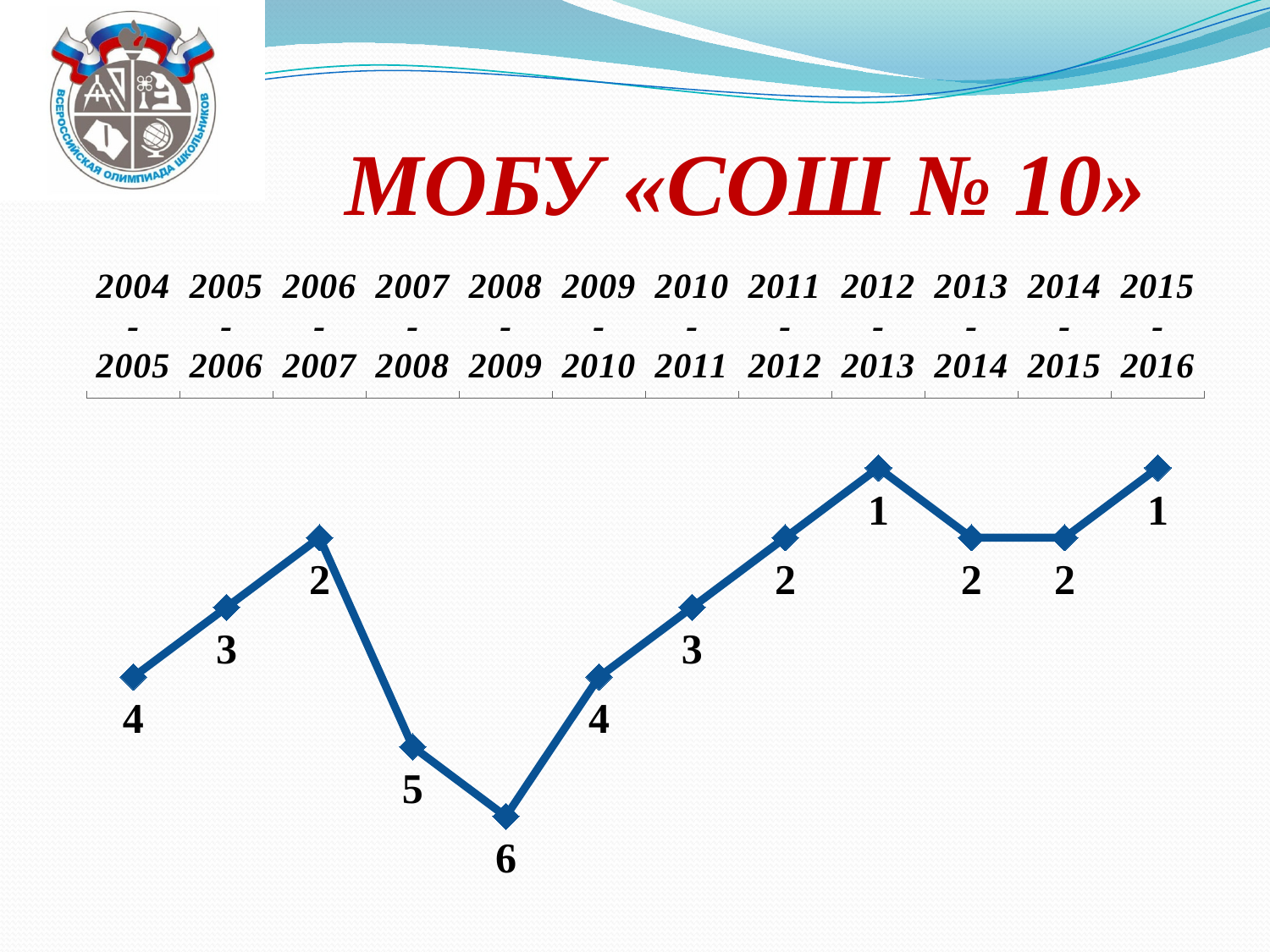
What is the difference between the values for 2008-2009 and 2004-2005? 2 What is the value for 2014-2015? 2 How many periods are plotted on the chart? 12 Which period has the largest numeric value? 2008-2009 What kind of chart is shown on the slide? line chart What is the value for 2004-2005? 4 Which is numerically larger, the value for 2007-2008 or the value for 2010-2011? 2007-2008 What is the value for 2010-2011? 3 What is the smallest numeric value plotted on the chart? 1 What is the value for 2012-2013? 1 What is the value for 2008-2009? 6 Do the numeric values rise or fall from 2006-2007 to 2008-2009? rise